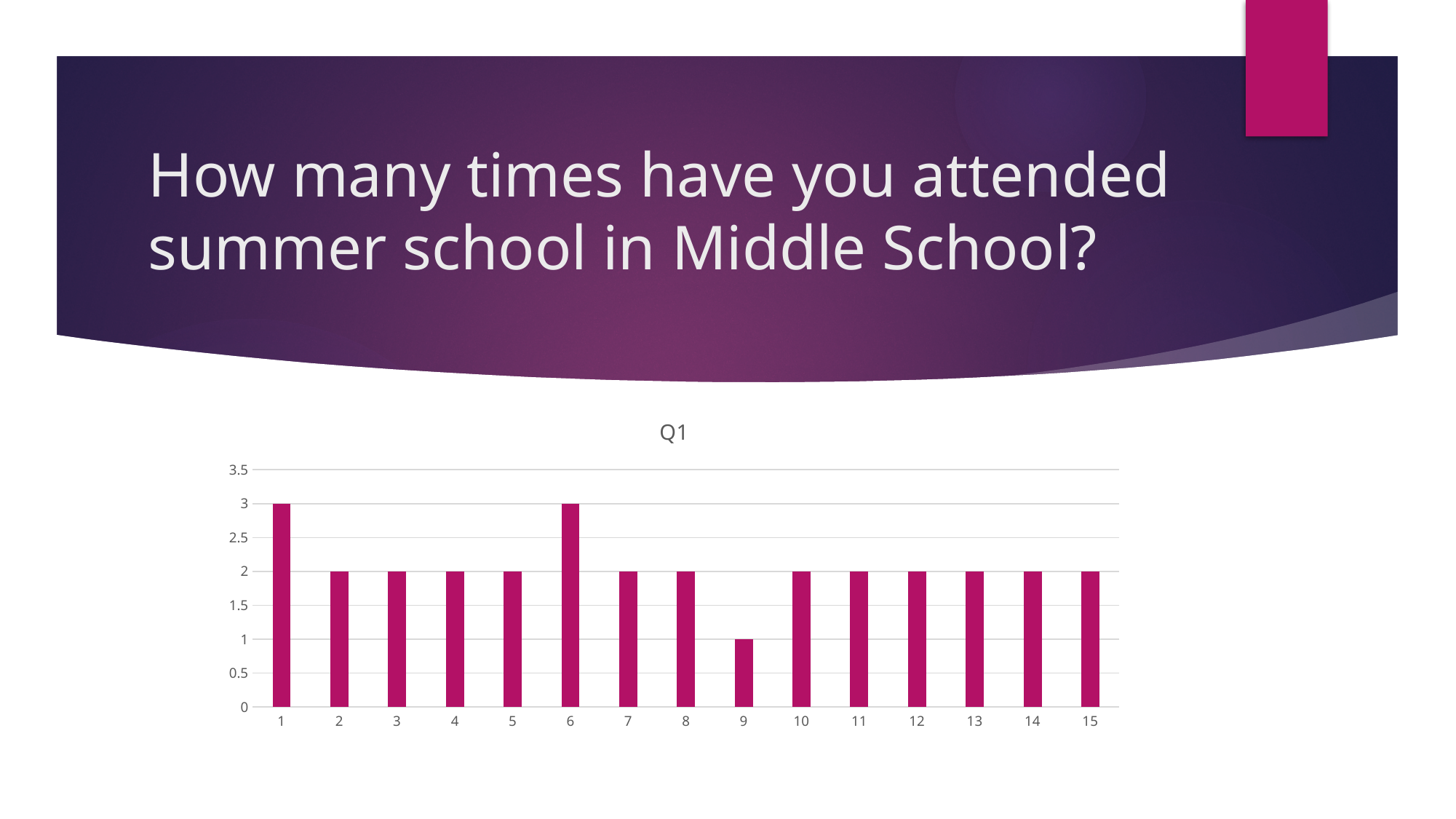
What is the title of the chart on the slide? Q1 How many categories are shown on the x axis of the Q1 chart? 15 What is the highest value shown on the y axis of the Q1 chart? 3.5 What is the difference between the values for category 1 and category 9 in the Q1 chart? 2 Which category has the lowest value in the Q1 chart? 9 What is the value for category 12 in the Q1 chart? 2 Which categories have the highest value in the Q1 chart? 1 and 6 What kind of chart is shown on the slide? bar chart What is the value for category 6 in the Q1 chart? 3 What is the value for category 9 in the Q1 chart? 1 Which is larger in the Q1 chart, the value for category 6 or the value for category 9? category 6 Is the value for category 9 in the Q1 chart greater or less than 2? less